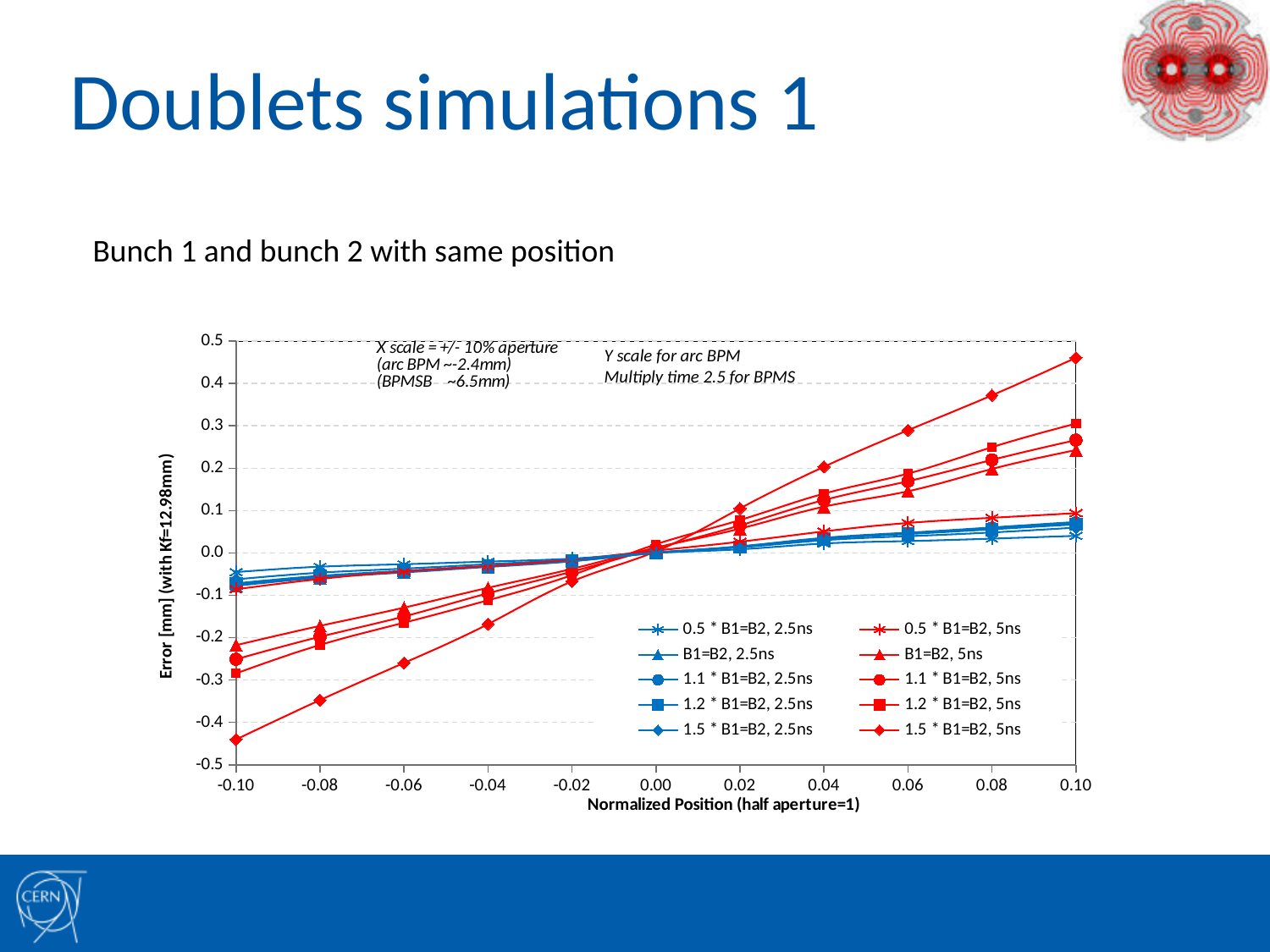
Do the values of the 1.5 * B1=B2, 5ns series rise or fall as the normalized position increases? rise How many series does the legend list? 10 What colour are the 5ns series drawn in? red Which series has the lowest value at normalized position -0.10? 1.5 * B1=B2, 5ns Which series has the highest value at normalized position 0.10? 1.5 * B1=B2, 5ns How many x-axis positions (data points per series) are plotted? 11 What kind of chart is shown on the slide? line chart Is the value for 1.5 * B1=B2, 5ns at normalized position 0.10 greater or less than 0.4? greater Is the value for 1.5 * B1=B2, 5ns at normalized position -0.08 greater or less than -0.3? less What is the title of the x axis? Normalized Position (half aperture=1) At normalized position 0.10, which is larger: 1.5 * B1=B2, 5ns or 1.2 * B1=B2, 5ns? 1.5 * B1=B2, 5ns